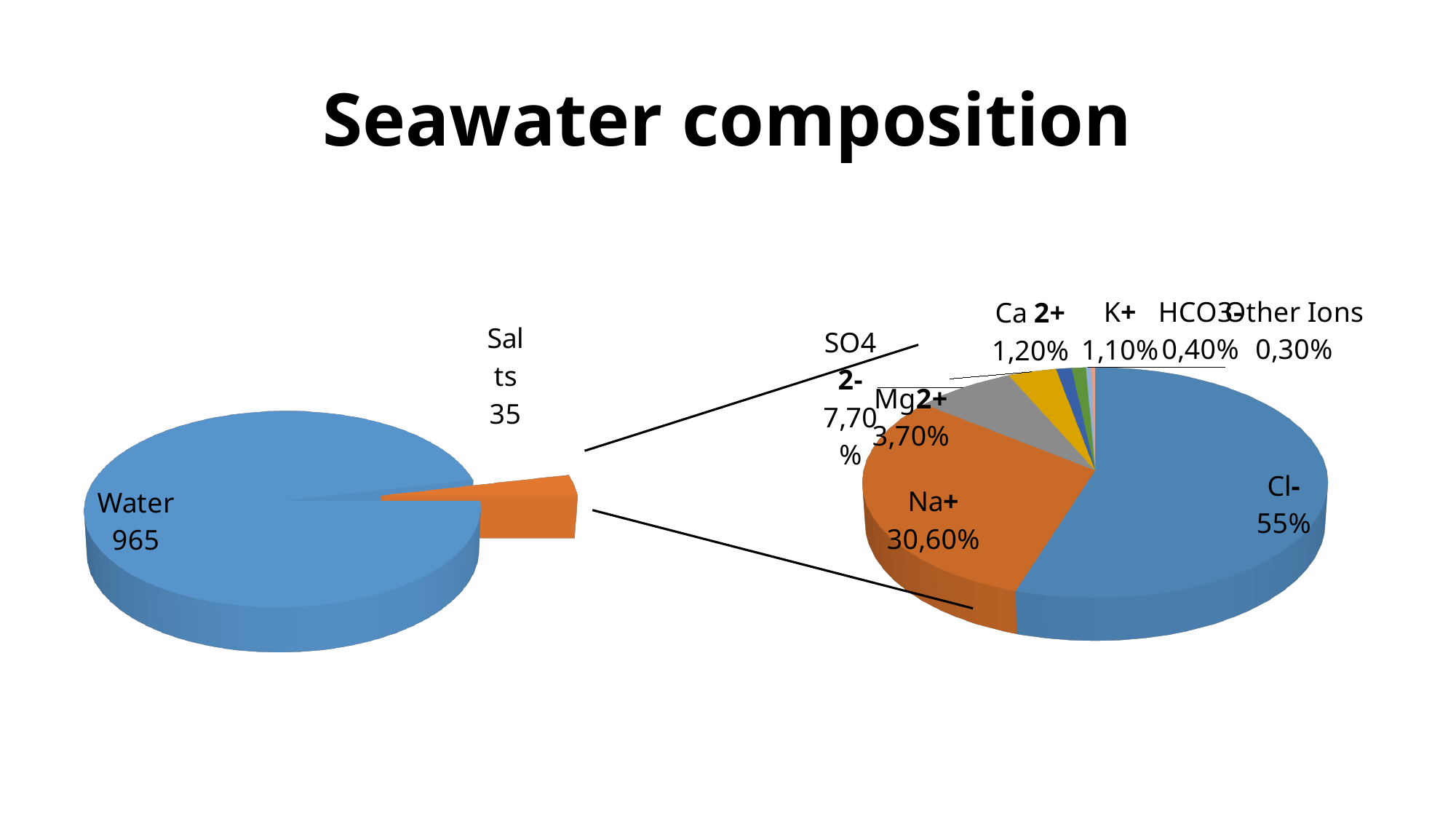
What kind of chart is the left chart on the slide? Pie chart On the left pie chart, what is the value for Salts? 35 On the right pie chart, which ion has the largest share? Cl- On the right pie chart, what is the share for Mg2+? 3,70% On the right pie chart, what is the share for SO4 2-? 7,70% On the right pie chart, which category has the smallest share? Other Ions On the right pie chart, what is the share for Na+? 30,60% How many slices does the right pie chart have? 8 On the right pie chart, what is the share for Cl-? 55% On the right pie chart, what is the difference between the shares of Cl- and Na+? 24,40% On the left pie chart, what is the value for Water? 965 On the right pie chart, which is larger, the share for Ca 2+ or the share for K+? Ca 2+